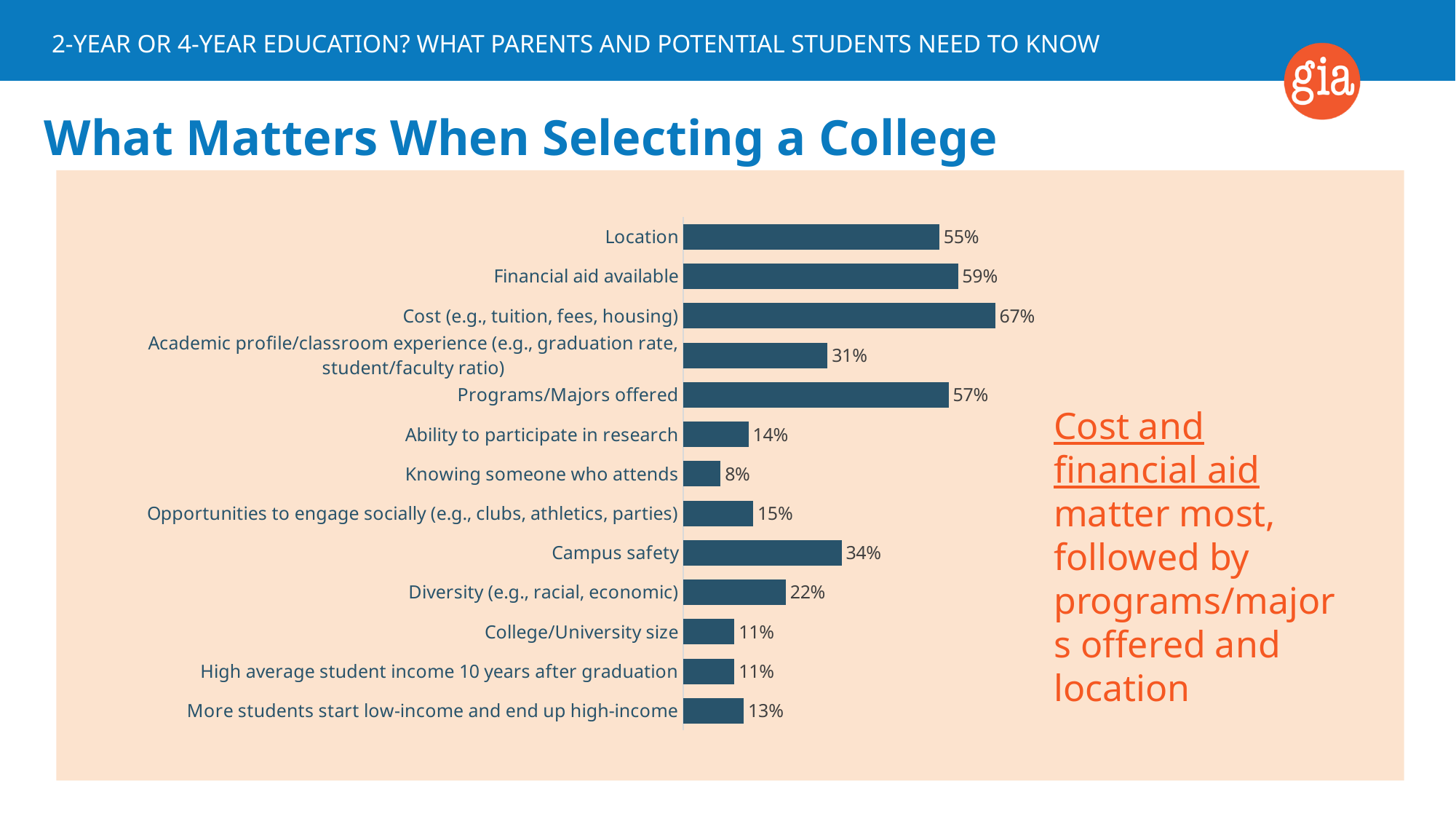
How many categories are shown in the chart? 13 What is the value shown for Knowing someone who attends? 8% Which category has the lowest value in the chart? Knowing someone who attends What is the difference between the values for Financial aid available and Location? 4% Which has a larger value, Campus safety or Diversity (e.g., racial, economic)? Campus safety What is the value shown for Campus safety? 34% What type of chart is shown on the slide? Bar chart What percentage of respondents said Cost (e.g., tuition, fees, housing) matters when selecting a college? 67% Which category has the highest value in the chart? Cost (e.g., tuition, fees, housing) What is the title of the slide containing the chart? What Matters When Selecting a College What is the difference between the values for Cost (e.g., tuition, fees, housing) and Programs/Majors offered? 10% Which has a larger value, Ability to participate in research or Opportunities to engage socially (e.g., clubs, athletics, parties)? Opportunities to engage socially (e.g., clubs, athletics, parties)